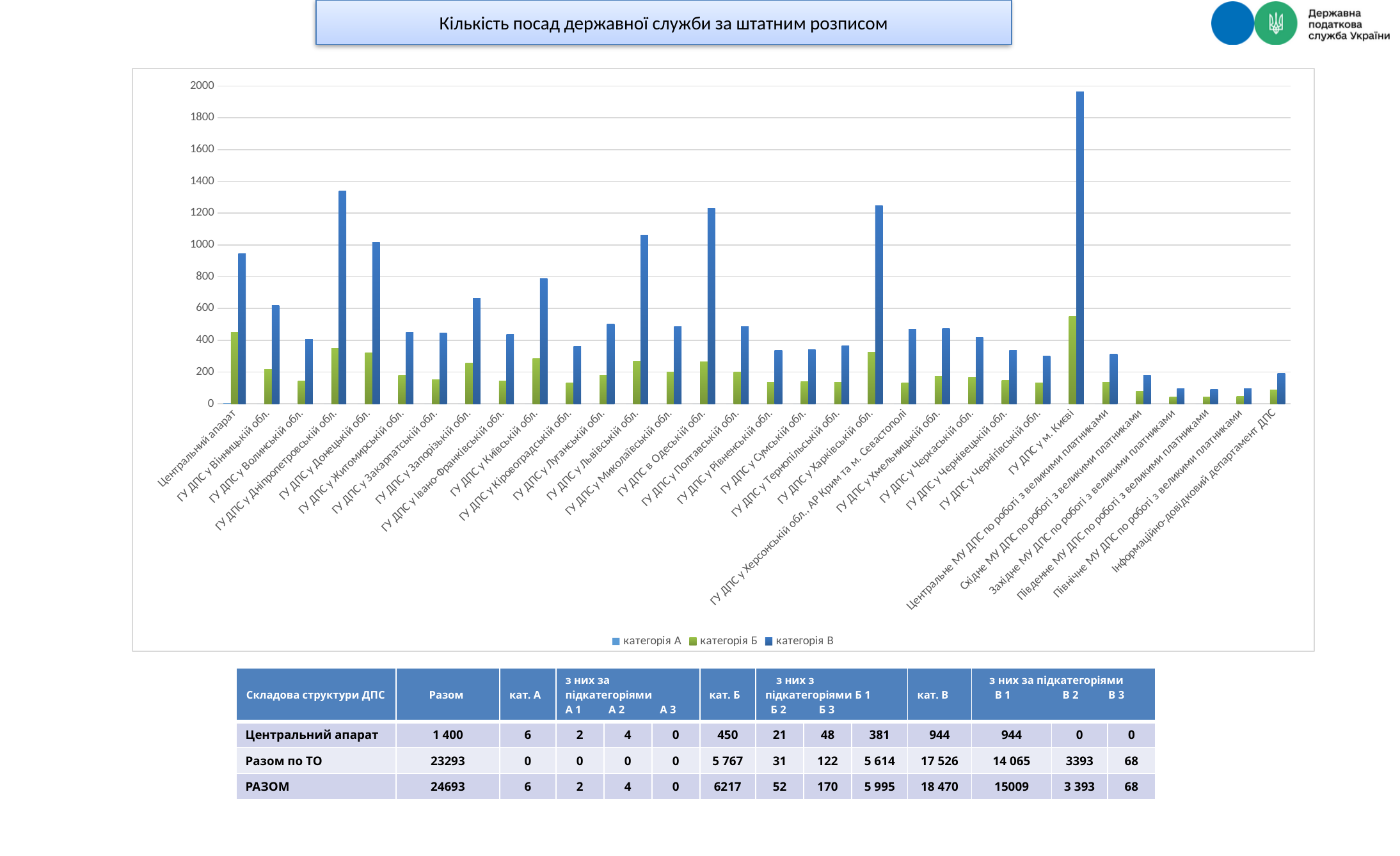
What is the категорія Б value for Центральний апарат? 450 How many series does the chart legend list? 3 What kind of chart is shown on the slide? bar chart Which category has the highest value for категорія Б? ГУ ДПС у м. Києві Which category has the highest value for категорія В? ГУ ДПС у м. Києві Is the категорія В value for ГУ ДПС у Дніпропетровській обл. greater or less than 1200? greater Which is larger for категорія В: ГУ ДПС у Дніпропетровській обл. or ГУ ДПС у Донецькій обл.? ГУ ДПС у Дніпропетровській обл. Is the категорія В value for ГУ ДПС у Волинській обл. greater or less than 600? less How many categories are shown along the x axis of the chart? 32 What is the категорія В value for Центральний апарат? 944 What are the three series named in the chart legend? категорія А, категорія Б, категорія В What is the title shown above the chart? Кількість посад державної служби за штатним розписом